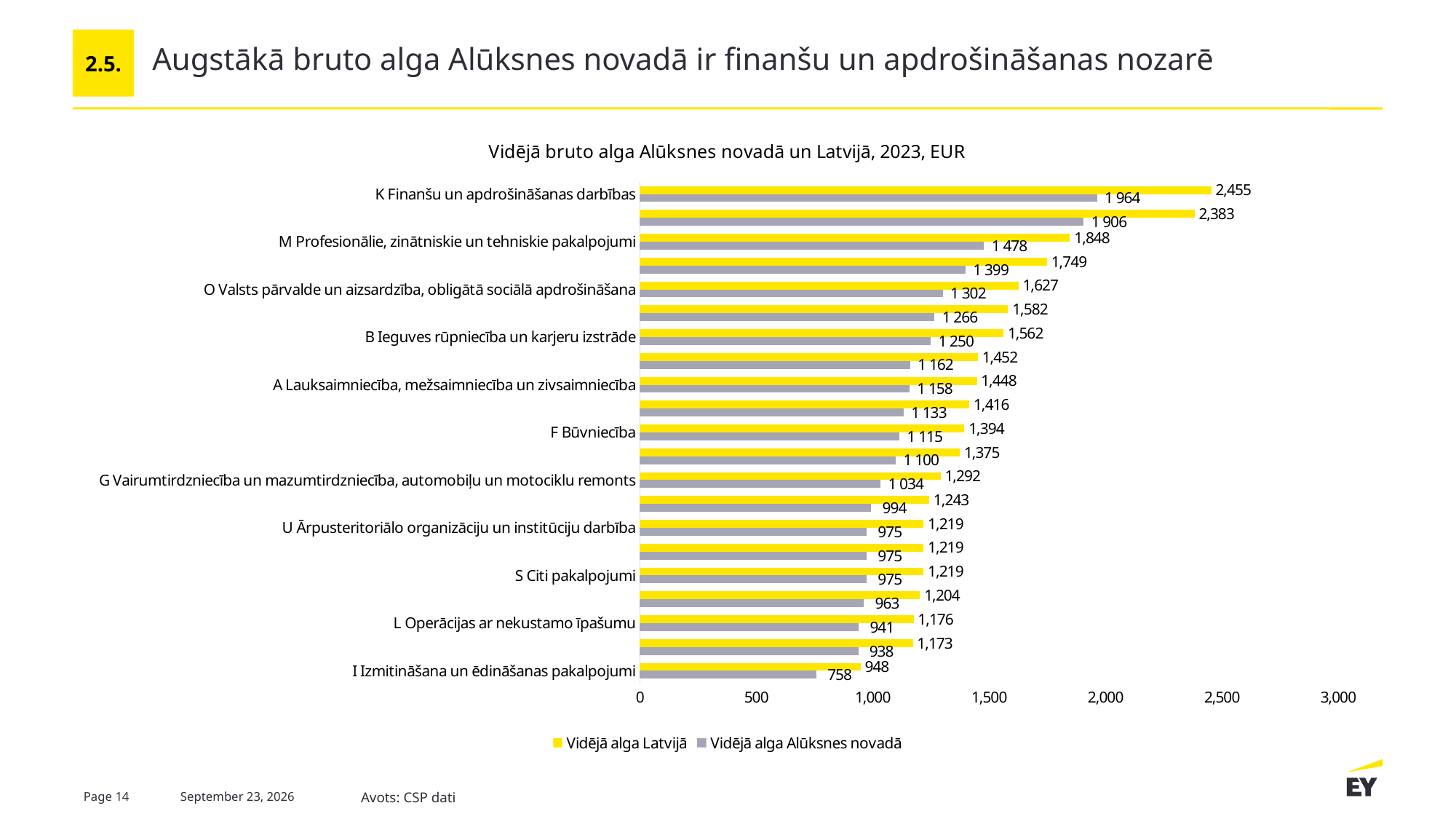
What is the value of Vidējā alga Latvijā for F Būvniecība? 1,394 What kind of chart is shown on the slide? bar chart Which is larger for O Valsts pārvalde un aizsardzība, obligātā sociālā apdrošināšana: Vidējā alga Latvijā or Vidējā alga Alūksnes novadā? Vidējā alga Latvijā Which colour represents Vidējā alga Alūksnes novadā in the chart? grey How many series does the legend list? 2 What is the value of Vidējā alga Alūksnes novadā for K Finanšu un apdrošināšanas darbības? 1 964 Which category has the lowest value for Vidējā alga Latvijā? I Izmitināšana un ēdināšanas pakalpojumi What is the value of Vidējā alga Alūksnes novadā for I Izmitināšana un ēdināšanas pakalpojumi? 758 What is the title of the chart? Vidējā bruto alga Alūksnes novadā un Latvijā, 2023, EUR What is the difference between Vidējā alga Latvijā and Vidējā alga Alūksnes novadā for M Profesionālie, zinātniskie un tehniskie pakalpojumi? 370 What is the value of Vidējā alga Latvijā for K Finanšu un apdrošināšanas darbības? 2,455 Which category has the highest value for Vidējā alga Alūksnes novadā? K Finanšu un apdrošināšanas darbības